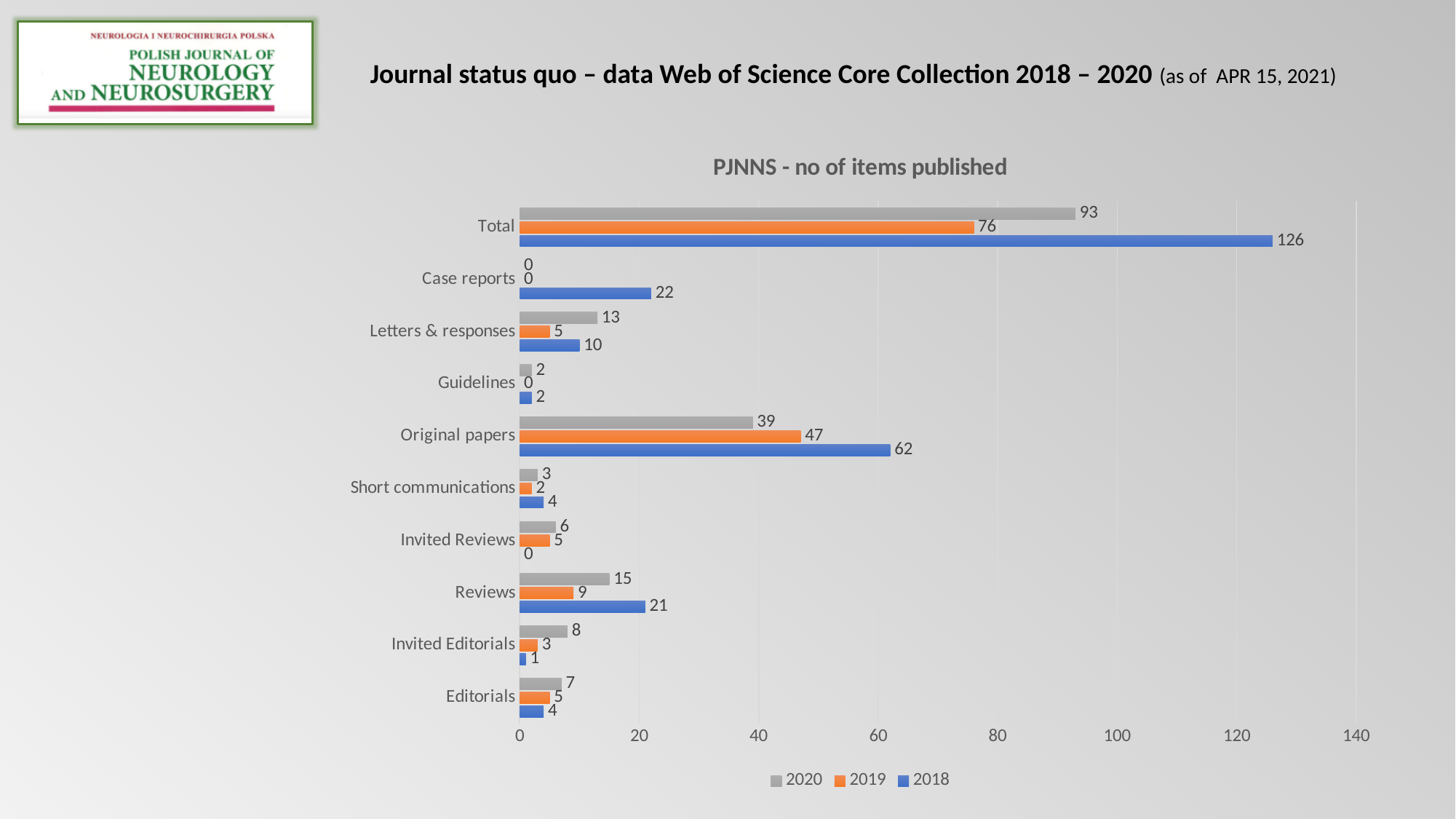
Is the value for Original papers in 2018 greater or less than 60? greater Which category (excluding Total) has the highest value for 2018? Original papers How many series does the legend list? 3 Which is larger for Reviews: the 2020 value or the 2019 value? 2020 What kind of chart is shown? bar chart What is the difference between the 2018 and 2020 values for Total? 33 How many Original papers were published in 2019? 47 How many categories are shown on the y axis? 10 Which year has the lowest value for Invited Reviews? 2018 What is the title of the chart? PJNNS - no of items published What is the value for Case reports in 2020? 0 What is the value for Total in 2018? 126